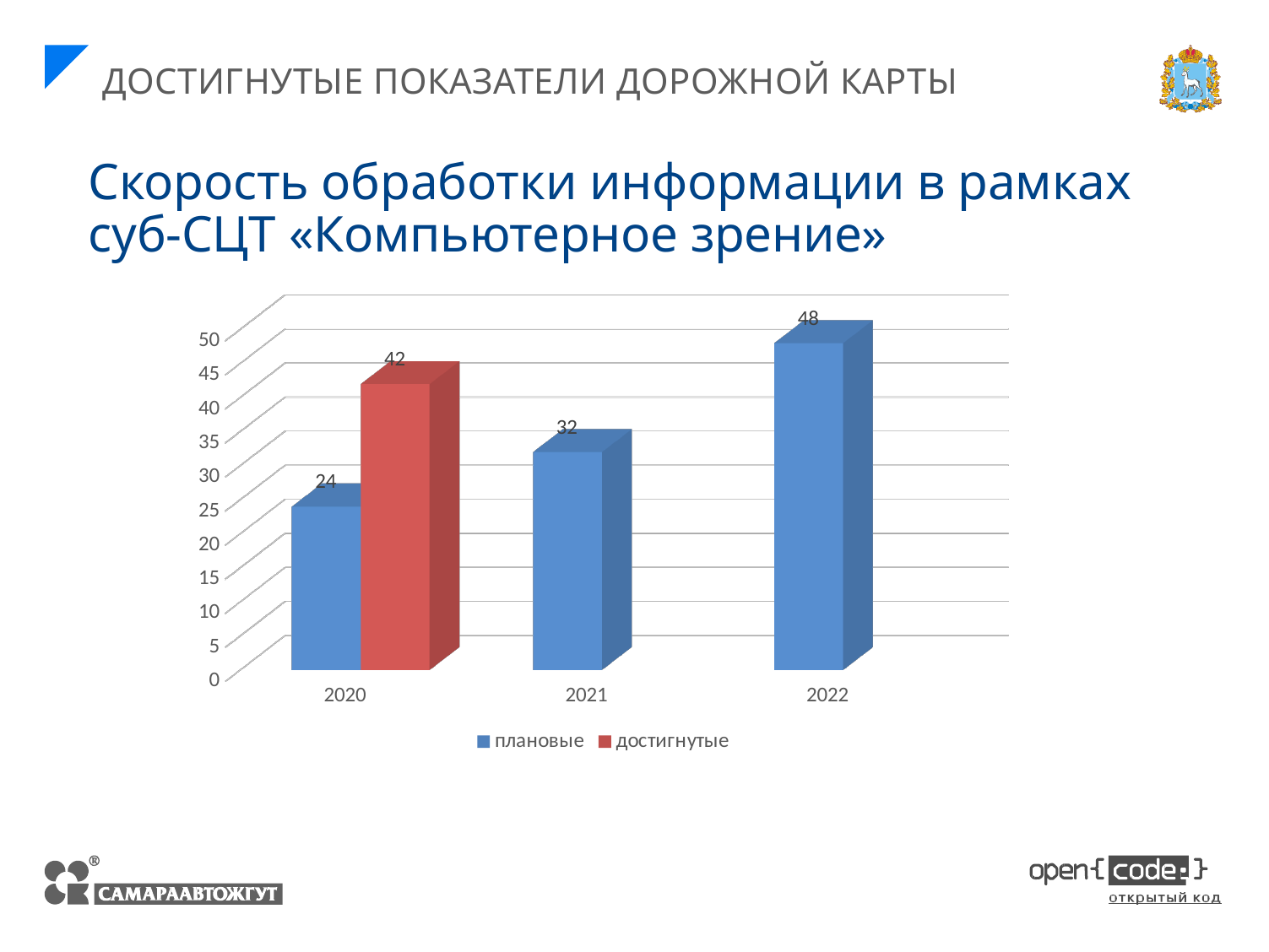
For 2020, which is larger: the planned value or the achieved value? достигнутые (achieved) What is the planned (плановые) value for 2022? 48 What is the difference between the achieved and planned values for 2020? 18 What is the achieved (достигнутые) value for 2020? 42 What is the difference between the planned values for 2022 and 2021? 16 Do the planned (плановые) values rise or fall from 2020 to 2022? Rise Which year has the highest planned (плановые) value? 2022 What kind of chart is shown on the slide? Bar chart What is the planned (плановые) value for 2020? 24 Which year has the lowest planned (плановые) value? 2020 How many series does the legend list? 2 What is the planned (плановые) value for 2021? 32